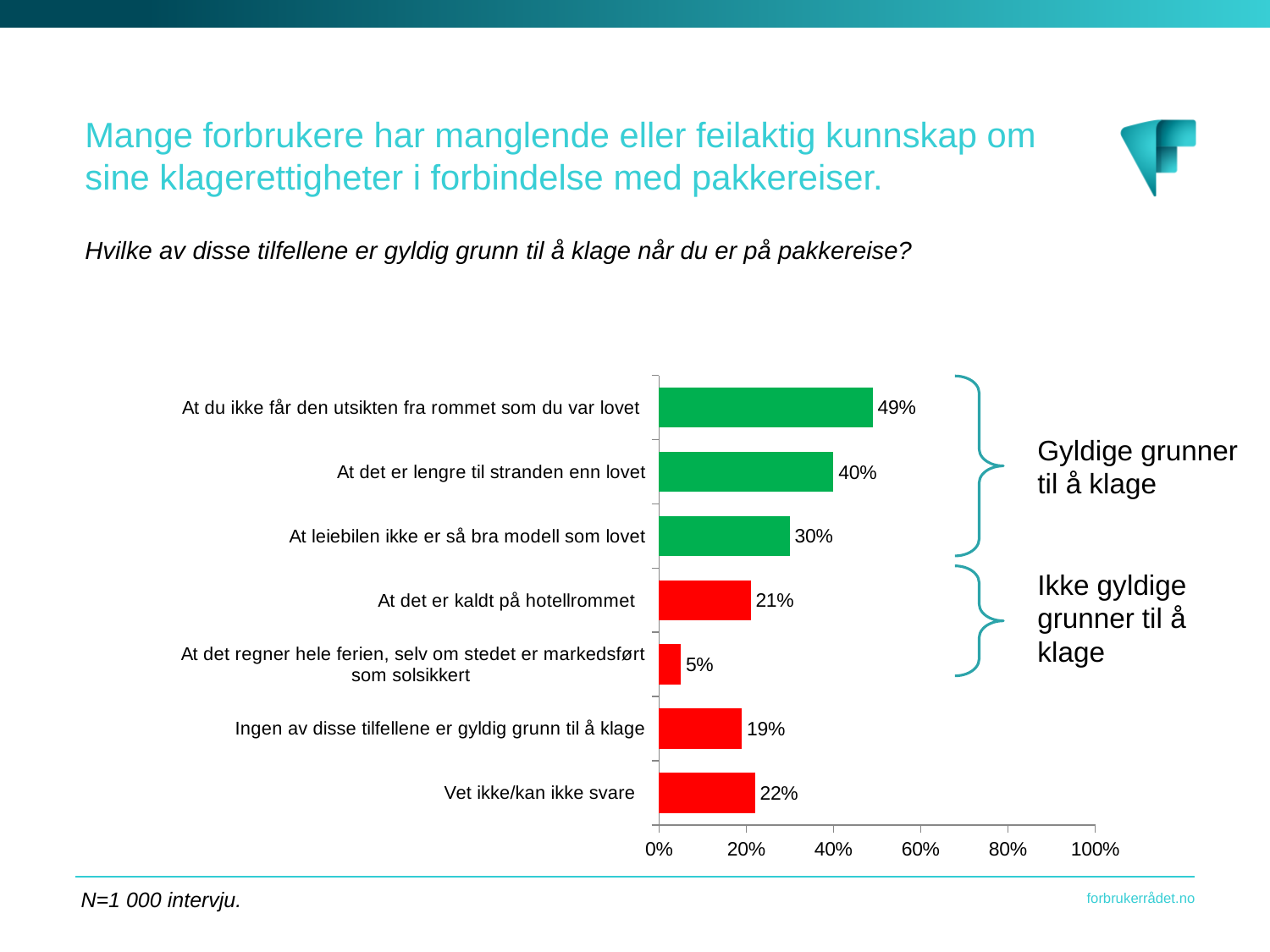
Is the value for "At leiebilen ikke er så bra modell som lovet" greater or less than 20%? greater Which category has the highest value? At du ikke får den utsikten fra rommet som du var lovet What is the difference between the values for "At det er lengre til stranden enn lovet" and "At leiebilen ikke er så bra modell som lovet"? 10 percentage points What is the value for "Vet ikke/kan ikke svare"? 22% What percentage of respondents chose "At du ikke får den utsikten fra rommet som du var lovet"? 49% How many categories are shown in the chart? 7 What colour are the bars for the categories labelled "Gyldige grunner til å klage"? Green What is the highest value shown on the x axis? 100% Which category has the lowest value? At det regner hele ferien, selv om stedet er markedsført som solsikkert Which is larger: the value for "Ingen av disse tilfellene er gyldig grunn til å klage" or for "Vet ikke/kan ikke svare"? Vet ikke/kan ikke svare What kind of chart is shown on the slide? Bar chart What is the value for "At det er kaldt på hotellrommet"? 21%